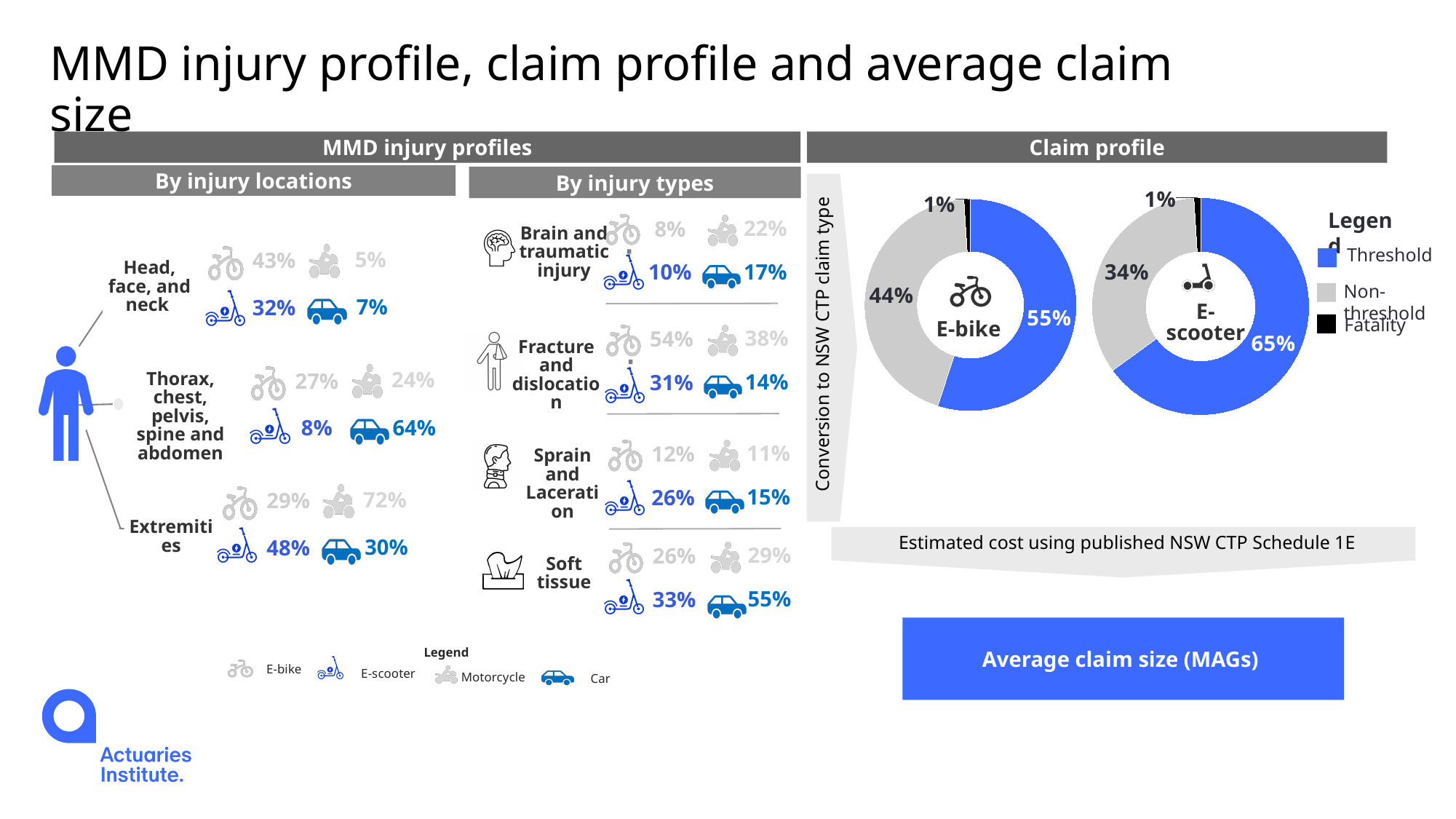
What kind of charts are used in the Claim profile section? Donut (pie) charts How many entries does the legend for the Claim profile donut charts list? 3 What is the difference between the Threshold share in the E-scooter donut chart and the Threshold share in the E-bike donut chart? 10% In the E-bike donut chart under Claim profile, what share is Threshold? 55% In the E-scooter donut chart, which claim type has the smallest share? Fatality In the E-bike donut chart, which claim type has the largest share? Threshold Which has a larger Non-threshold share: the E-bike donut chart or the E-scooter donut chart? E-bike In the E-scooter donut chart, what share is Non-threshold? 34% In the Claim profile donut charts, which colour represents Threshold claims? Blue In the E-scooter donut chart, what share is Fatality? 1% In the E-bike donut chart, what share is Non-threshold? 44% In the E-scooter donut chart under Claim profile, what share is Threshold? 65%